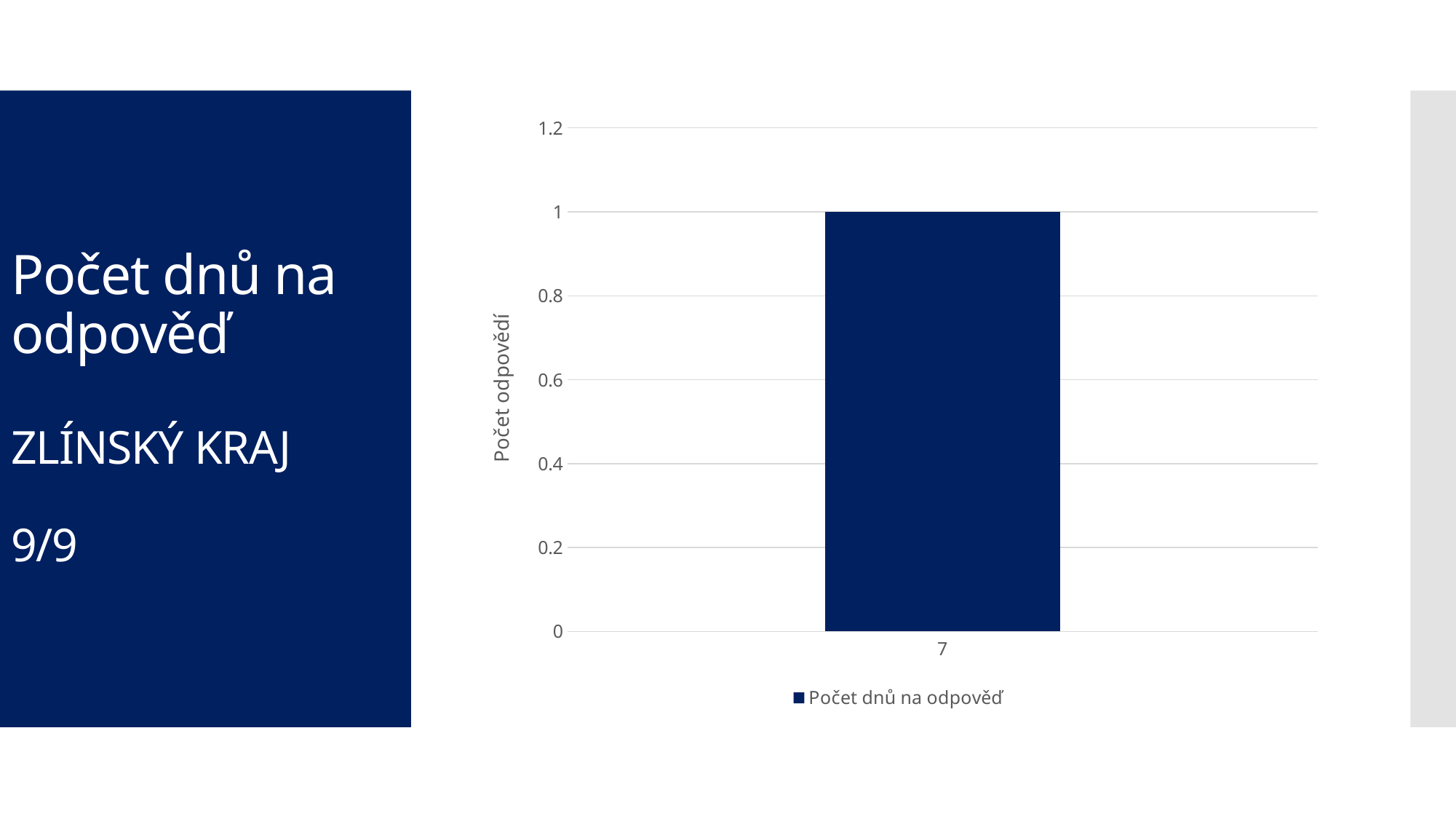
Is the value for category 7 greater or less than 0.8? greater What kind of chart is shown on the slide? bar chart What is the value of the bar for category 7? 1 How many categories are shown on the x axis of the chart? 1 What is the label of the only category on the x axis? 7 What is the name of the series shown in the chart legend? Počet dnů na odpověď Is the value for category 7 greater or less than 1.2? less How many series does the chart legend list? 1 What is the label of the vertical axis of the chart? Počet odpovědí